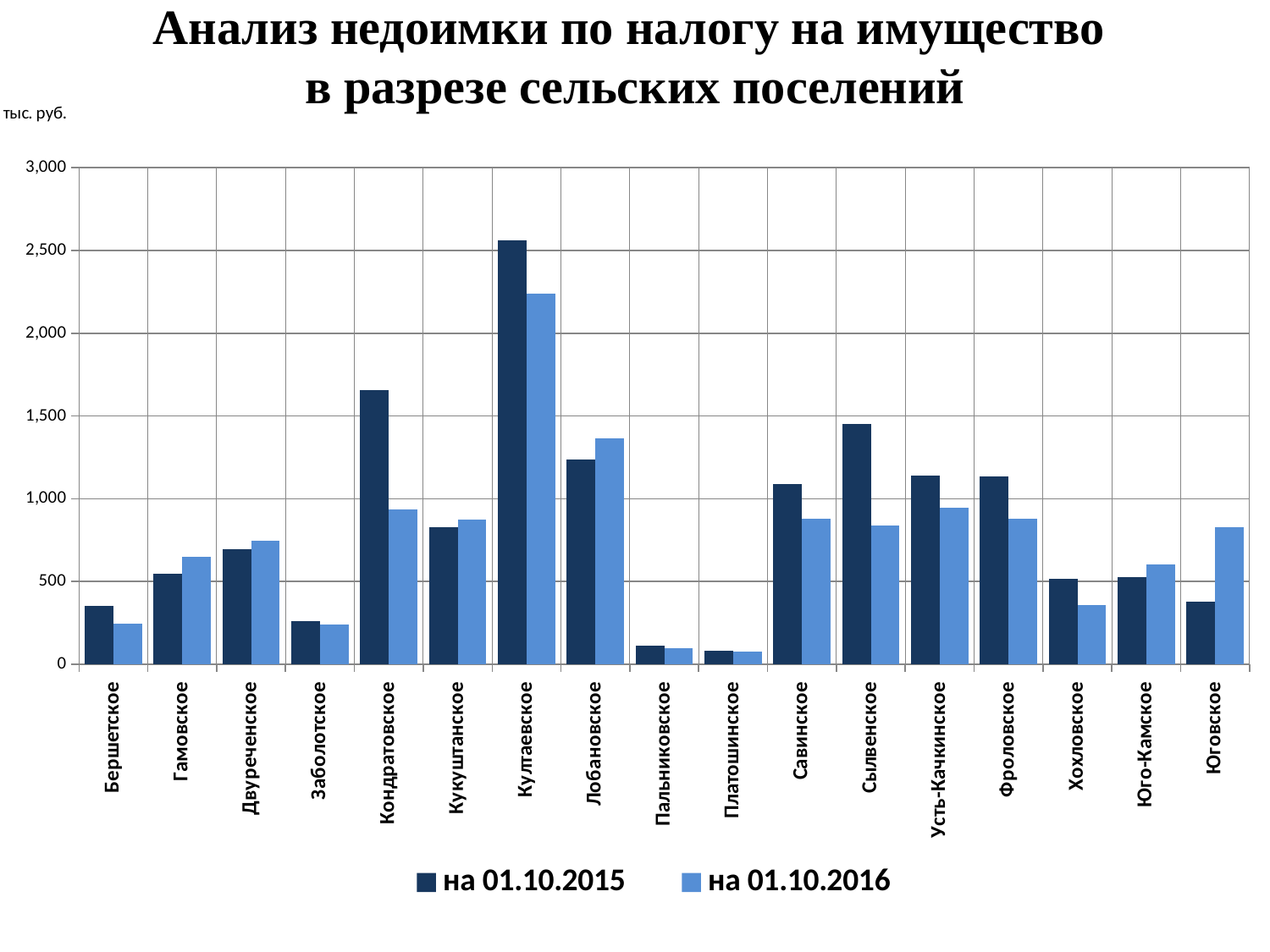
Which settlement has the highest value for на 01.10.2016? Култаевское Is the value for Кондратовское на 01.10.2016 greater or less than 1,000? less Which settlement has the highest value for на 01.10.2015? Култаевское What unit is indicated for the values on the chart? тыс. руб. What kind of chart is shown on the slide? bar chart For Лобановское, which is larger: the value на 01.10.2015 or на 01.10.2016? на 01.10.2016 Is the value for Култаевское на 01.10.2015 greater or less than 2,000? greater Is the value for Кондратовское на 01.10.2015 greater or less than 1,500? greater For Сылвенское, which is larger: the value на 01.10.2015 or на 01.10.2016? на 01.10.2015 How many series does the legend list? 2 How many settlements (categories) are shown on the x axis? 17